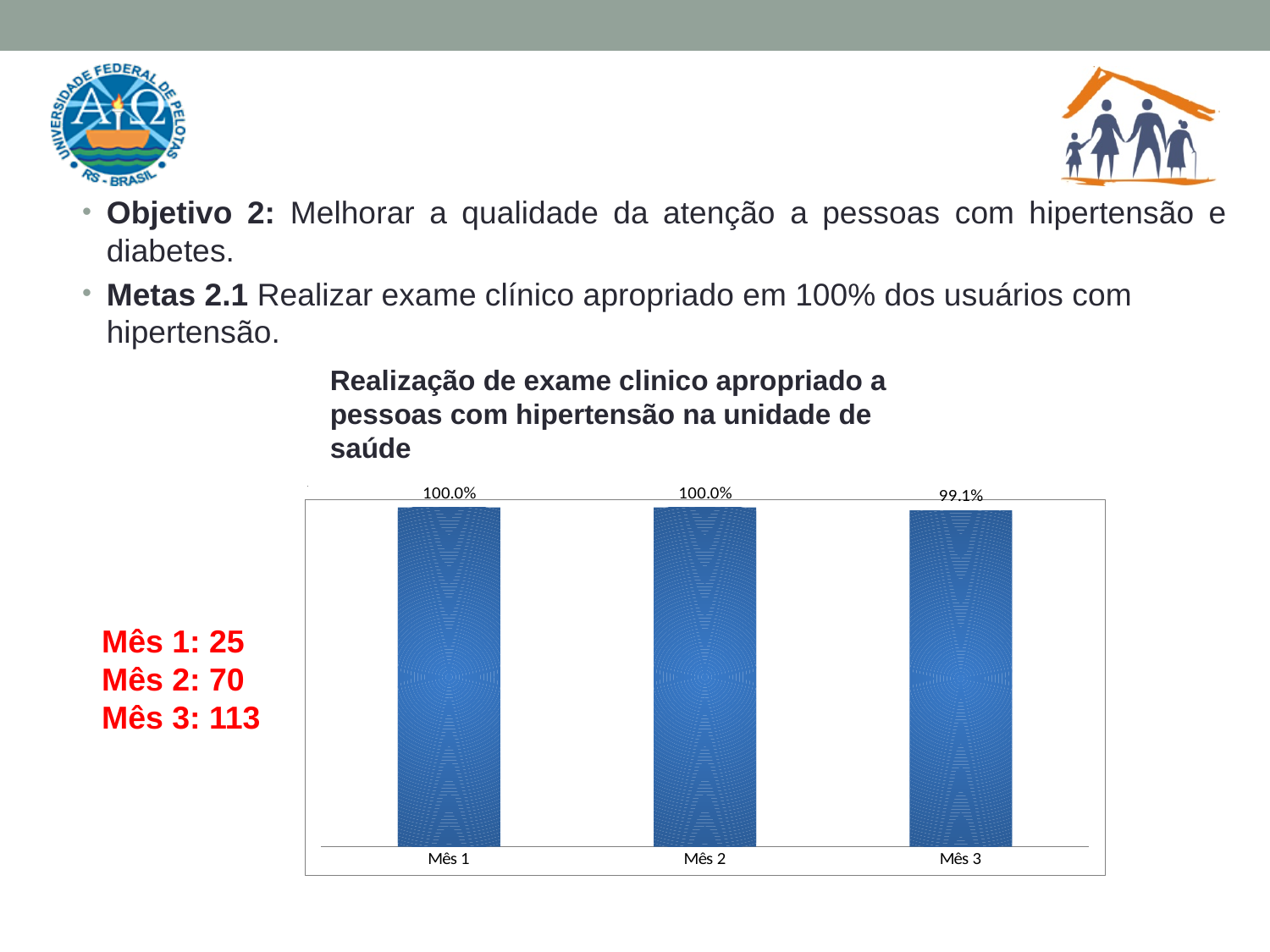
What is the value for Mês 2 in the chart? 100.0% Which is larger, the value for Mês 2 or the value for Mês 3? Mês 2 What is the value for Mês 1 in the chart? 100.0% Do the values rise or fall from Mês 2 to Mês 3? Fall What is the value for Mês 3 in the chart? 99.1% How many categories are shown on the x axis of the chart? 3 What is the difference between the values for Mês 1 and Mês 3? 0.9% What kind of chart is shown on the slide? Bar chart What colour are the bars in the chart? Blue Which month has the lowest value in the chart? Mês 3 What is the title of the chart? Realização de exame clinico apropriado a pessoas com hipertensão na unidade de saúde Do Mês 1 and Mês 2 have the same value in the chart? Yes